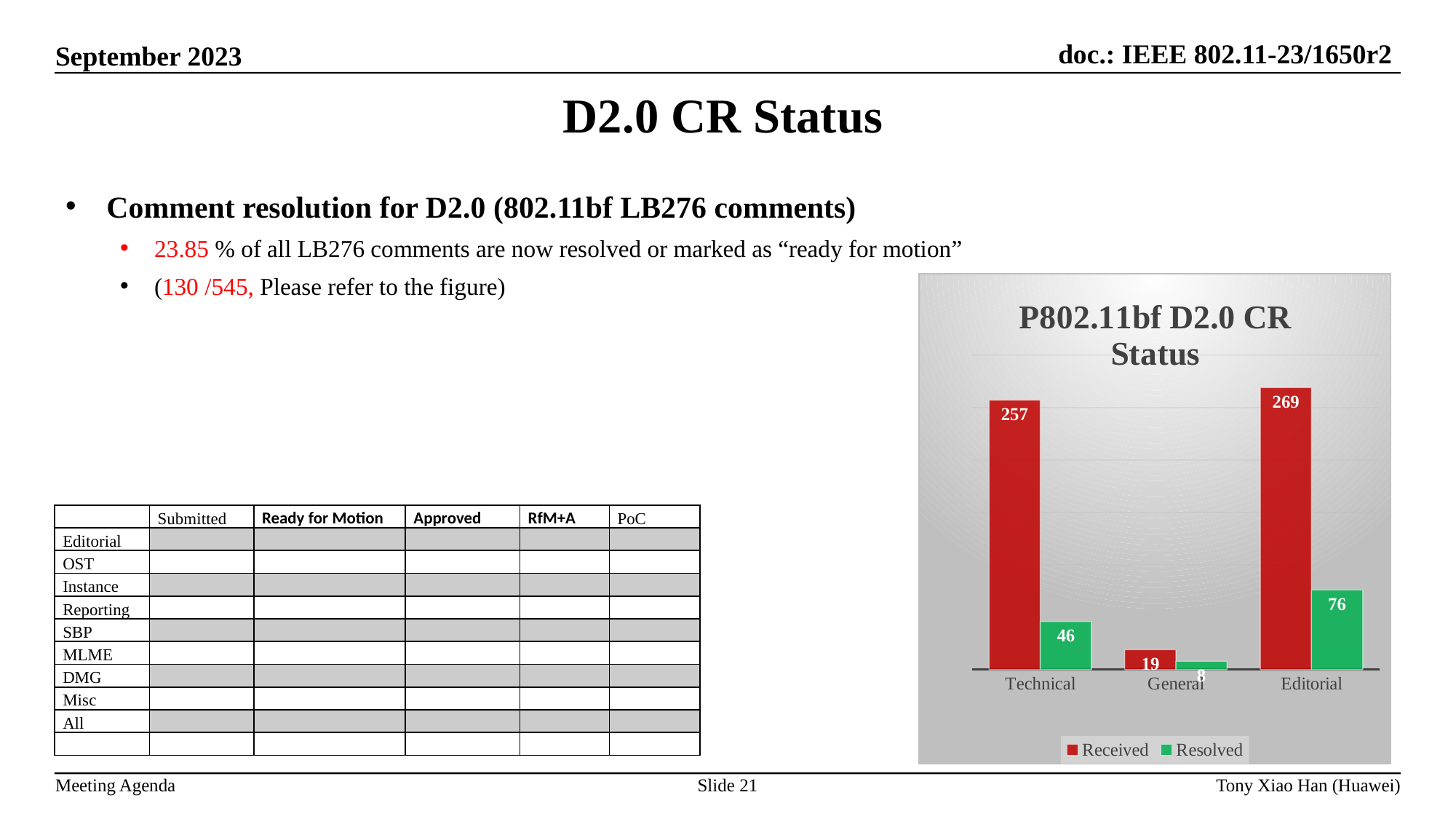
What is the Received value for General? 19 What is the difference between the Received values for Editorial and Technical? 12 Which has a larger Resolved value, Technical or Editorial? Editorial What is the Received value for Technical? 257 What is the Resolved value for Editorial? 76 For Technical, how much larger is the Received value than the Resolved value? 211 What kind of chart is shown on the slide? Bar chart Which category has the lowest Received value? General How many series does the legend list? 2 Which category has the highest Received value? Editorial What is the Resolved value for Technical? 46 How many categories are shown on the x axis? 3